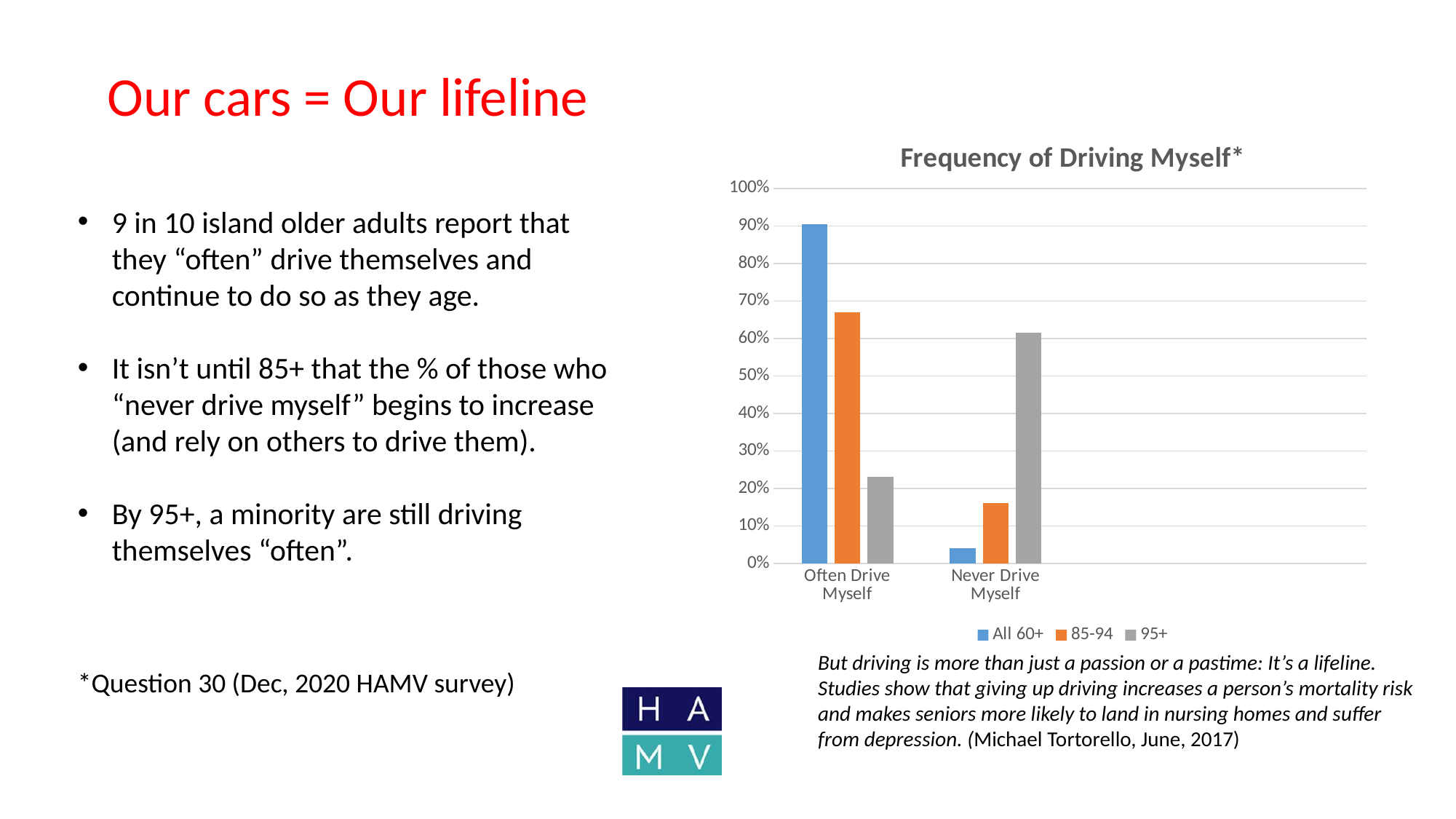
What kind of chart is shown on the slide? bar chart Which series has the highest value for Often Drive Myself? All 60+ Which is larger: the 85-94 value for Often Drive Myself or the 85-94 value for Never Drive Myself? Often Drive Myself How many series does the chart legend list? 3 Is the value for All 60+ in Often Drive Myself greater or less than 80%? greater Which series has the lowest value for Often Drive Myself? 95+ Which series has the highest value for Never Drive Myself? 95+ What is the title of the chart? Frequency of Driving Myself* Is the value for 95+ in Never Drive Myself greater or less than 50%? greater Is the value for 95+ in Often Drive Myself greater or less than 30%? less How many categories are shown on the x axis of the chart? 2 Which series has the lowest value for Never Drive Myself? All 60+